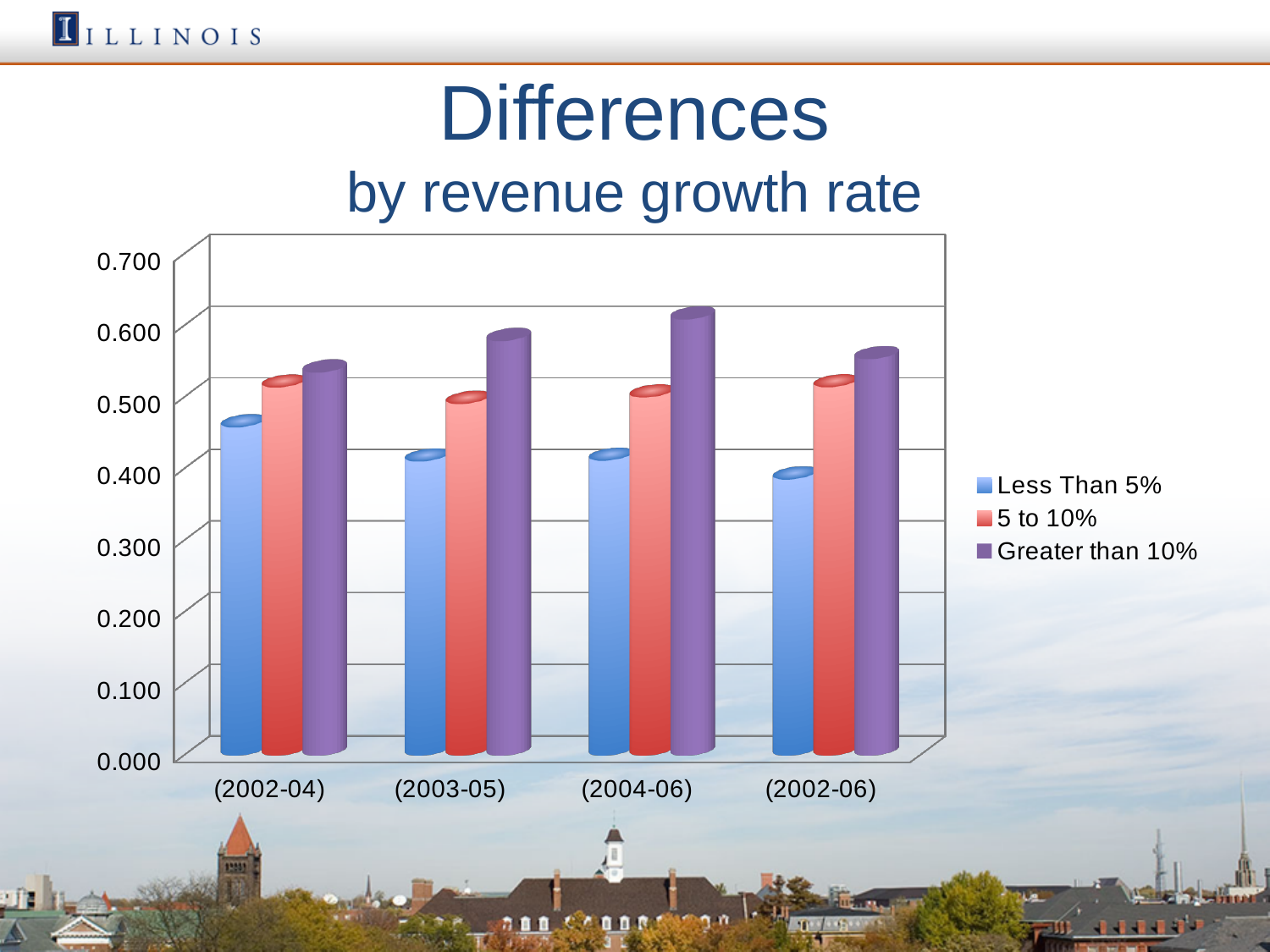
How many series does the legend list? 3 What colour represents the Greater than 10% series in the legend? purple How many period categories are shown on the x axis? 4 Is the value for Greater than 10% in (2004-06) greater or less than 0.500? greater In (2004-06), which series has the highest value? Greater than 10% In (2002-04), which is larger: Less Than 5% or 5 to 10%? 5 to 10% For the Greater than 10% series, which is larger: (2002-04) or (2004-06)? (2004-06) Which period has the highest value for the Greater than 10% series? (2004-06) Is the value for 5 to 10% in (2003-05) greater or less than 0.400? greater What kind of chart is shown on the slide? bar chart Which period has the lowest value for the Less Than 5% series? (2002-06) Is the value for Less Than 5% in (2002-06) greater or less than 0.500? less